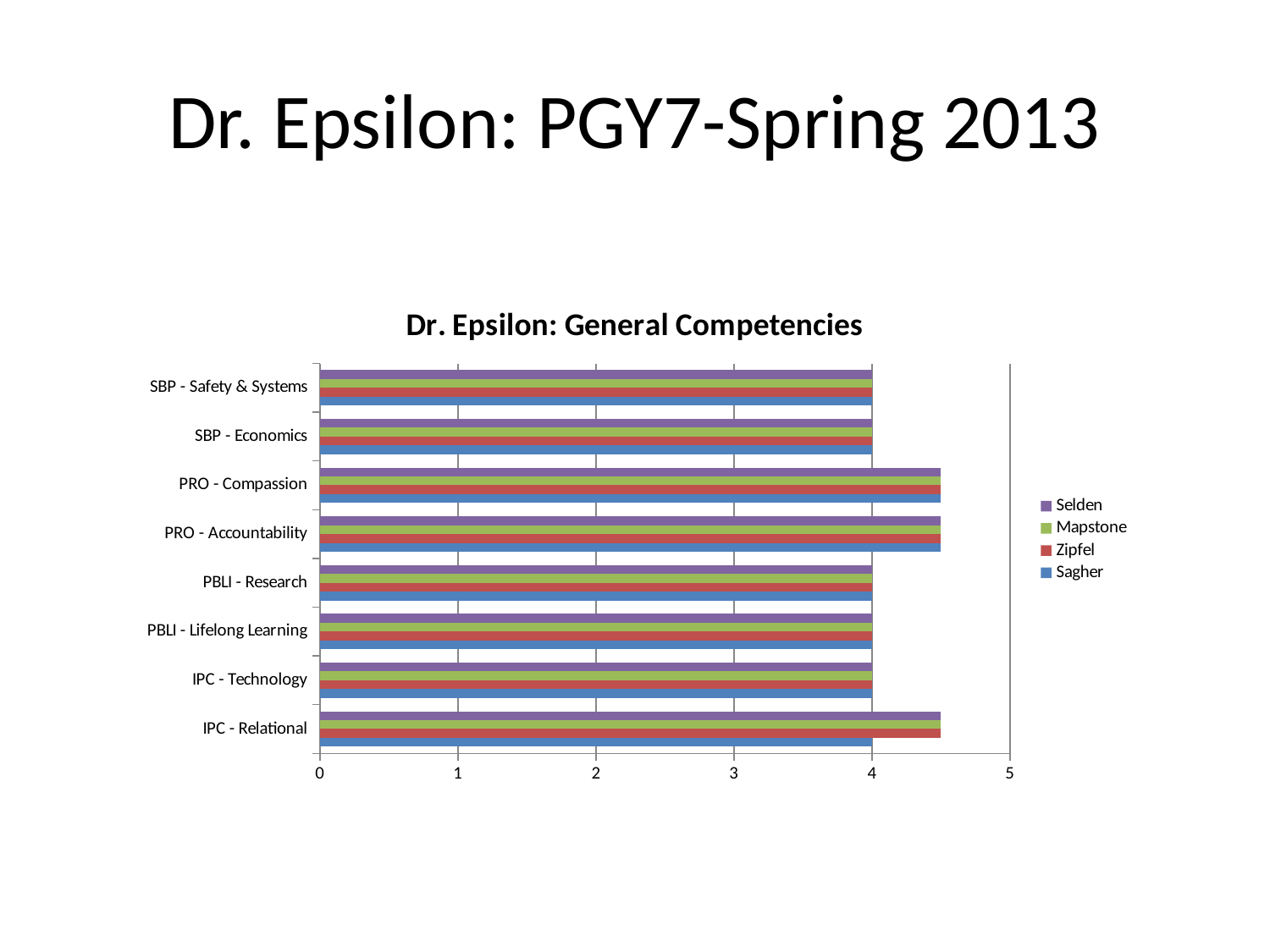
How many series does the legend list? 4 For IPC - Relational, which is larger: the Zipfel value or the Sagher value? Zipfel Which series is listed first in the legend? Selden What kind of chart is shown on the slide? bar chart What is the Sagher value for IPC - Relational? 4 What is the Selden value for PBLI - Research? 4 How many competency categories are shown on the chart? 8 What is the Sagher value for SBP - Economics? 4 What is the title of the chart? Dr. Epsilon: General Competencies Which is larger: the Sagher value for PRO - Compassion or the Sagher value for IPC - Technology? PRO - Compassion Is the Mapstone value for PRO - Accountability greater or less than 5? less Is the Selden value for PRO - Compassion greater or less than 4? greater